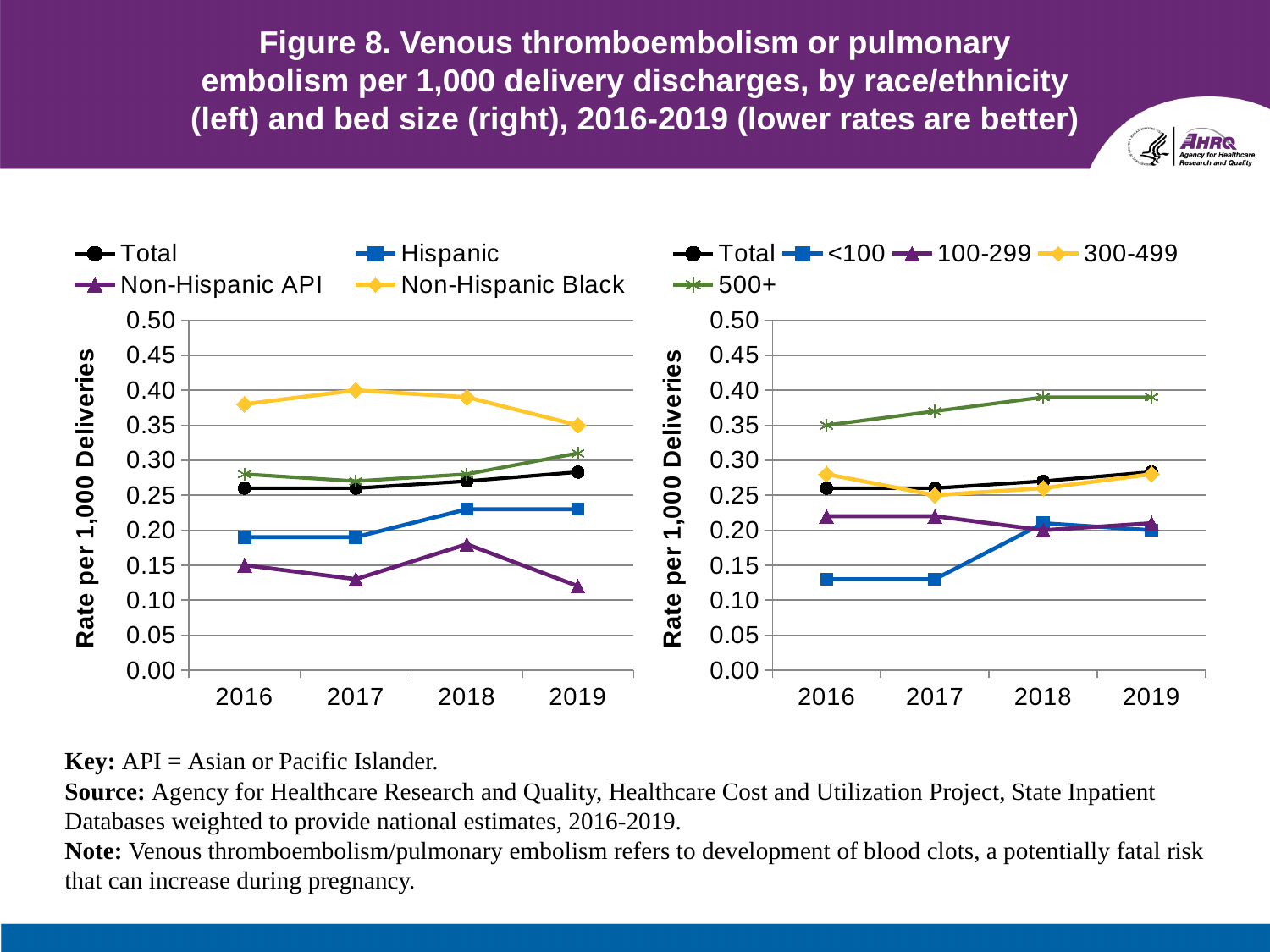
In the right (bed size) chart, is the 500+ rate in 2019 greater or less than 0.35? greater In the right (bed size) chart, which bed size category had the highest rate in 2018? 500+ How many years are shown on the x axis of the left (race/ethnicity) chart? 4 In the left (race/ethnicity) chart, which is larger in 2016: the Non-Hispanic Black rate or the Hispanic rate? Non-Hispanic Black What type of chart is used on the left (race/ethnicity) panel of the slide? Line chart In the left (race/ethnicity) chart, which group had the highest rate in 2017? Non-Hispanic Black How many series does the legend of the left (race/ethnicity) chart list? 4 In the right (bed size) chart, which bed size category had the lowest rate in 2016? <100 In the left (race/ethnicity) chart, which group had the lowest rate in 2019? Non-Hispanic API In the right (bed size) chart, does the <100 series rise or fall from 2017 to 2018? Rise How many series does the legend of the right (bed size) chart list? 5